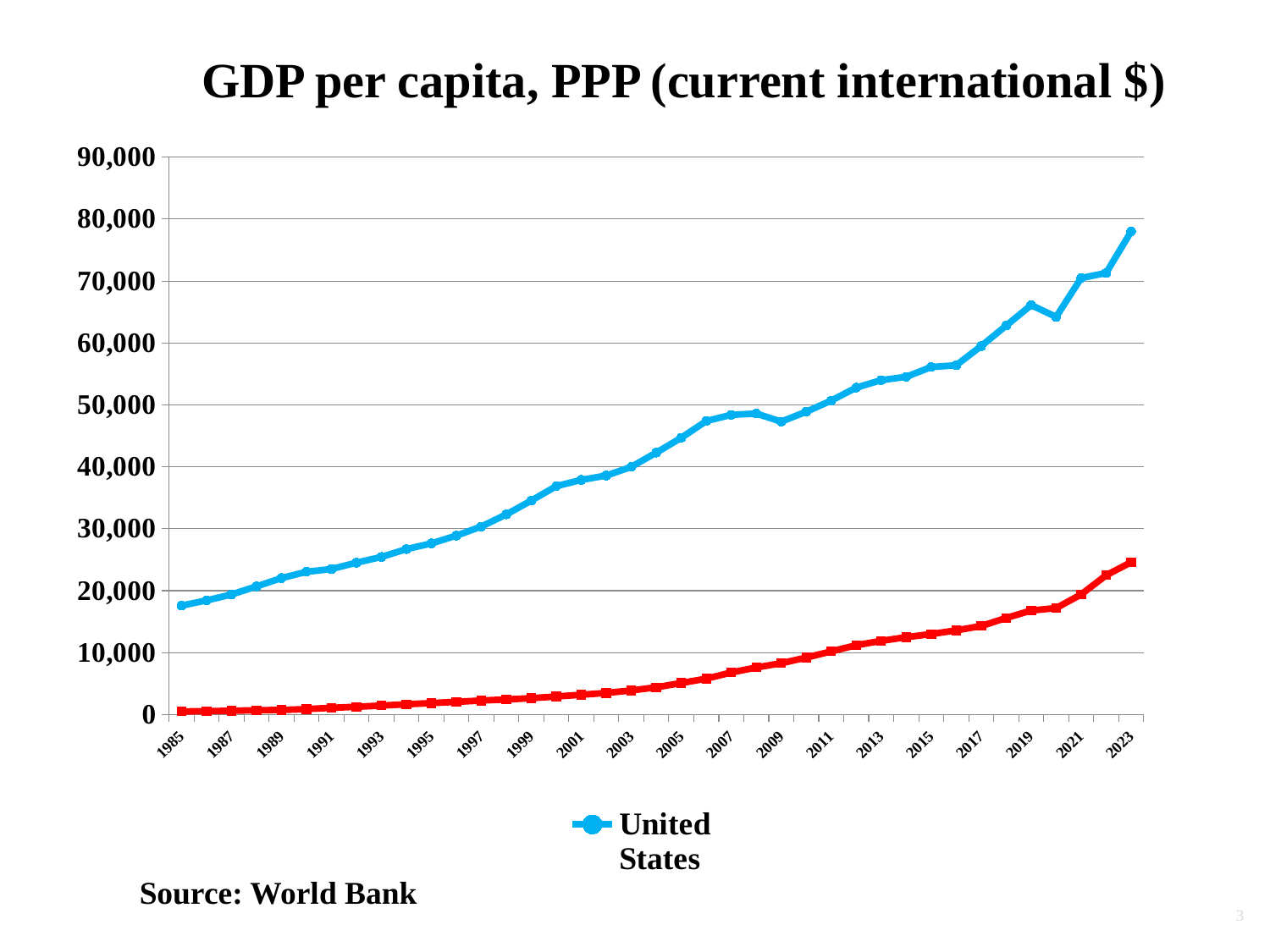
Does the United States series rise or fall from 1985 to 2023? rise How many series does the legend list? 1 In which year is the United States value highest? 2023 What is the title of the chart? GDP per capita, PPP (current international $) In which year is the United States value lowest? 1985 What kind of chart is shown on the slide? line chart Is the United States value for 2009 greater or less than 50,000? less Is the United States value for 2019 greater or less than 60,000? greater Is the United States value for 1985 greater or less than 20,000? less Which is larger for the United States, the value in 2020 or the value in 2023? 2023 What source is cited for the chart? World Bank